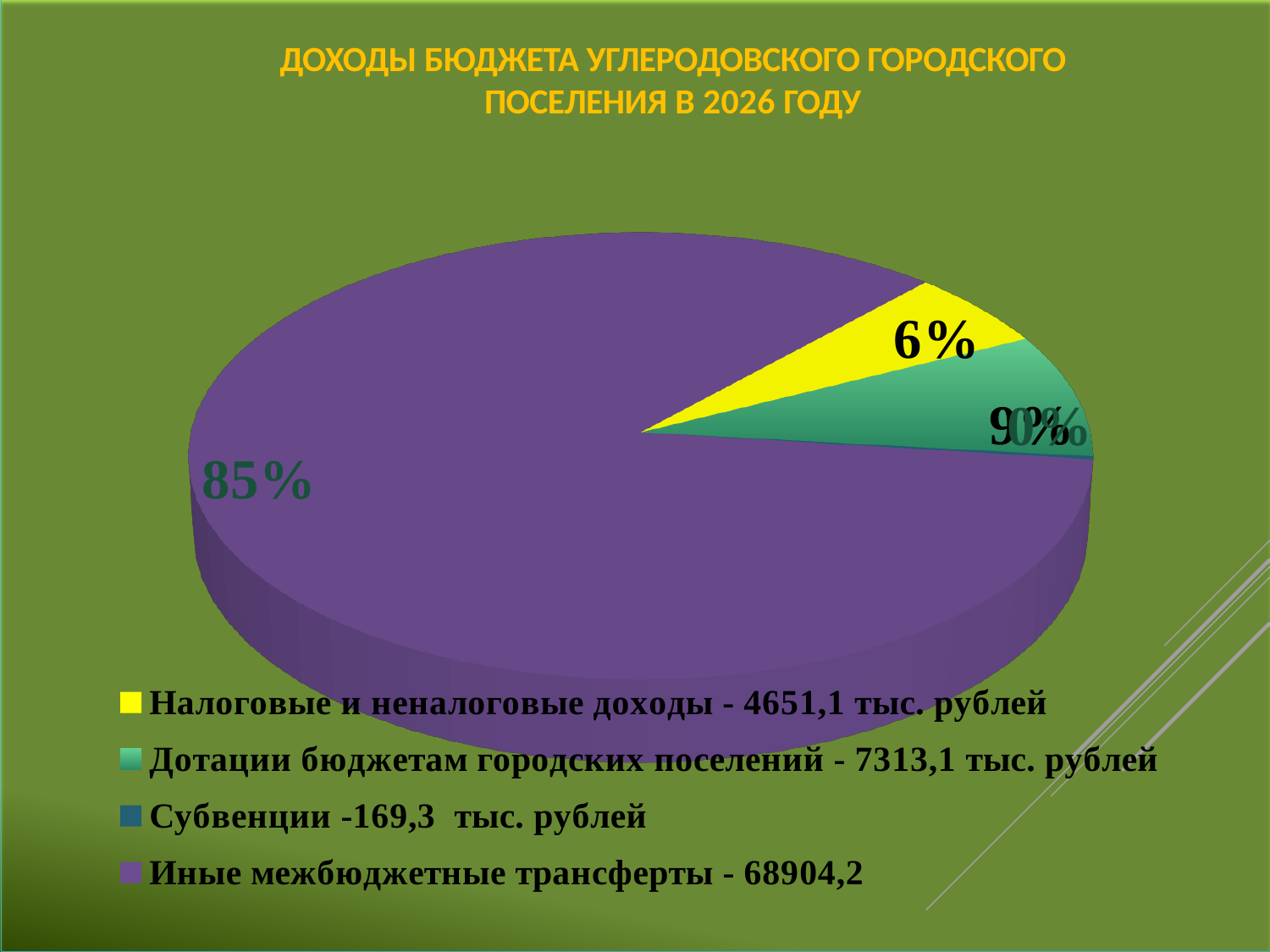
What amount does the legend give for Субвенции? 169,3 тыс. рублей How many categories does the pie chart show? 4 What amount does the legend give for Налоговые и неналоговые доходы? 4651,1 тыс. рублей What colour is the slice for Иные межбюджетные трансферты? purple Which category has the smallest slice of the pie? Субвенции What amount does the legend give for Дотации бюджетам городских поселений? 7313,1 тыс. рублей What is the difference in percentage points between the Иные межбюджетные трансферты slice and the Налоговые и неналоговые доходы slice? 79% Which category has the largest slice of the pie? Иные межбюджетные трансферты What kind of chart is shown on the slide? pie chart What share of the pie is labelled for Налоговые и неналоговые доходы? 6% Which is larger: Дотации бюджетам городских поселений or Налоговые и неналоговые доходы? Дотации бюджетам городских поселений What share of the pie is labelled for Иные межбюджетные трансферты? 85%